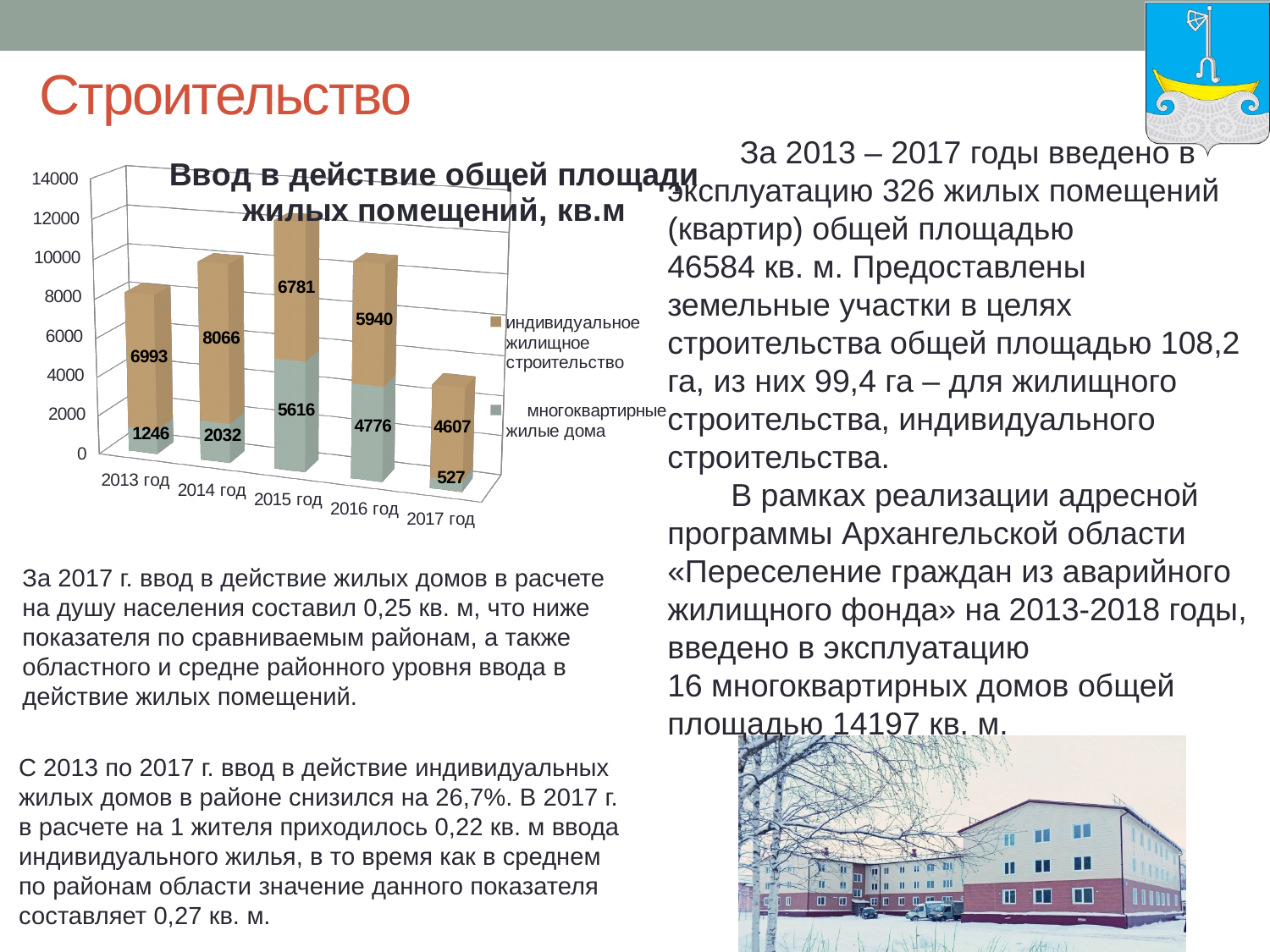
What is the value for многоквартирные жилые дома in 2017 год? 527 How many series does the legend list? 2 What is the title of the chart? Ввод в действие общей площади жилых помещений, кв.м What type of chart is shown on the slide? stacked bar chart Which is larger: многоквартирные жилые дома in 2016 год or in 2014 год? 2016 год What is the total of the stacked bar for 2015 год? 12397 What is the value for многоквартирные жилые дома in 2015 год? 5616 Which year has the highest value for индивидуальное жилищное строительство? 2014 год Which year has the lowest value for многоквартирные жилые дома? 2017 год What is the value for индивидуальное жилищное строительство in 2014 год? 8066 What is the difference between the индивидуальное жилищное строительство values for 2013 год and 2017 год? 2386 How many years are shown on the x axis? 5